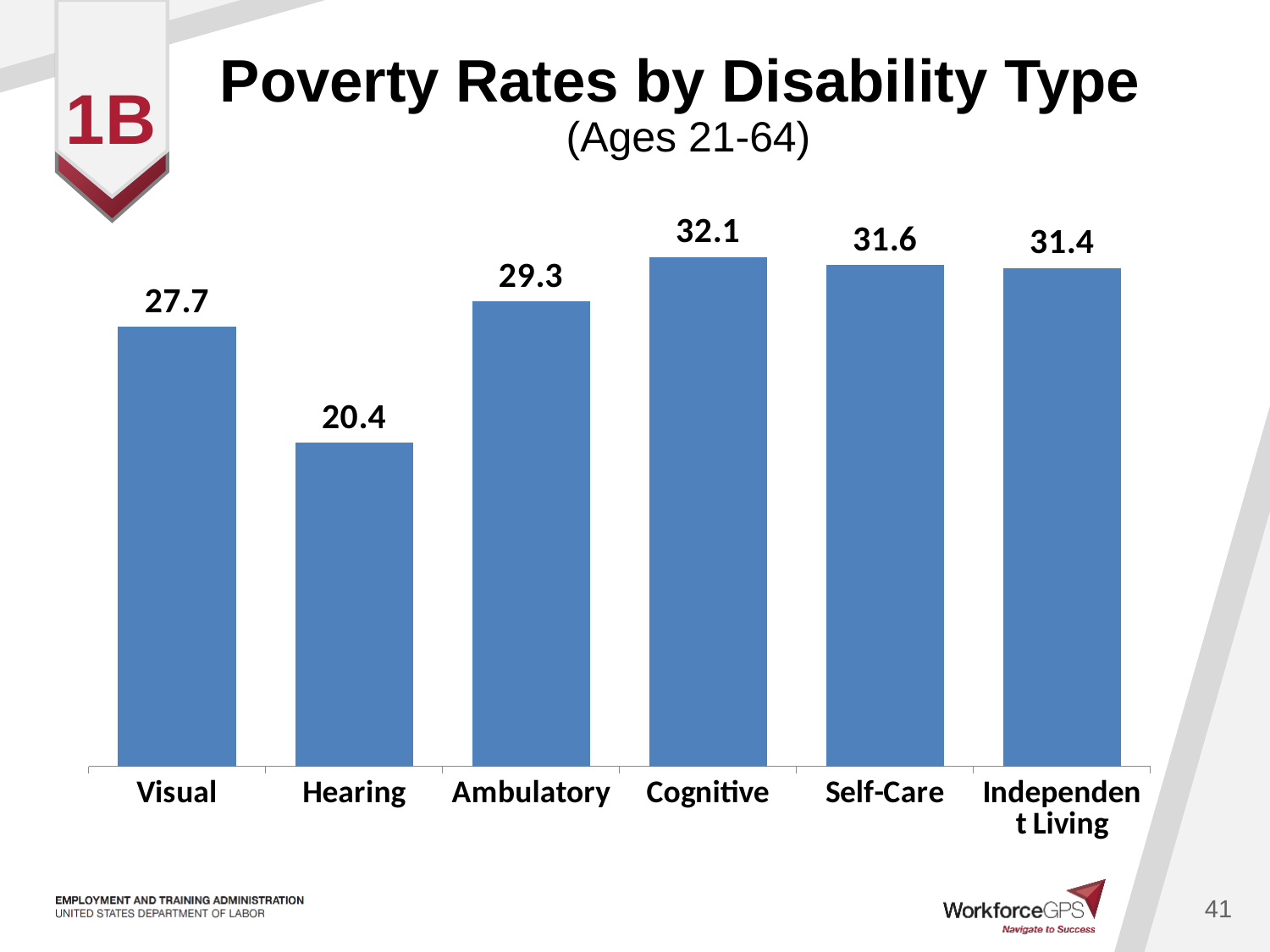
What age range does the chart title say the poverty rates cover? Ages 21-64 Which disability type has the lowest poverty rate? Hearing What is the poverty rate for the Ambulatory disability type? 29.3 What is the difference between the poverty rates for Cognitive and Hearing? 11.7 What is the poverty rate for the Self-Care disability type? 31.6 What is the poverty rate for the Hearing disability type? 20.4 How many disability types are shown in the chart? 6 Which disability type has the highest poverty rate? Cognitive Which has a higher poverty rate, Visual or Ambulatory? Ambulatory What kind of chart is shown on the slide? Bar chart What is the difference between the poverty rates for Ambulatory and Visual? 1.6 What is the poverty rate for the Visual disability type? 27.7